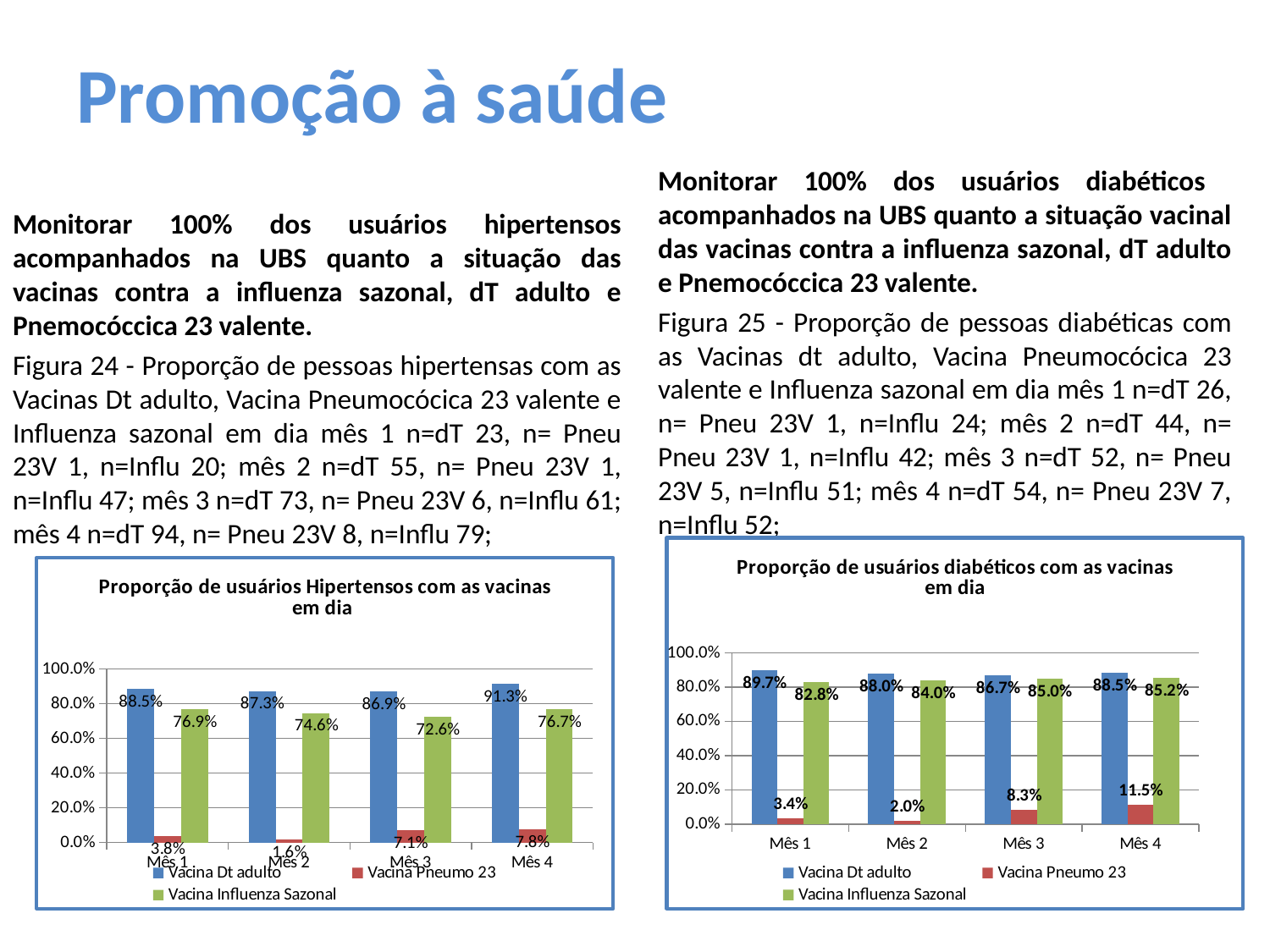
In the chart titled 'Proporção de usuários diabéticos com as vacinas em dia', what is the value for Vacina Influenza Sazonal in Mês 2? 84.0% In the chart titled 'Proporção de usuários diabéticos com as vacinas em dia', does Vacina Influenza Sazonal rise or fall from Mês 1 to Mês 4? rise In the chart titled 'Proporção de usuários diabéticos com as vacinas em dia', in which month is Vacina Dt adulto highest? Mês 1 In the chart titled 'Proporção de usuários Hipertensos com as vacinas em dia', what is the value for Vacina Influenza Sazonal in Mês 3? 72.6% In the chart titled 'Proporção de usuários Hipertensos com as vacinas em dia', what is the value for Vacina Dt adulto in Mês 4? 91.3% In the chart titled 'Proporção de usuários Hipertensos com as vacinas em dia', in which month is Vacina Pneumo 23 lowest? Mês 2 In the chart titled 'Proporção de usuários Hipertensos com as vacinas em dia', how many series does the legend list? 3 In the chart titled 'Proporção de usuários diabéticos com as vacinas em dia', how many months are shown on the x axis? 4 What kind of chart is the chart titled 'Proporção de usuários diabéticos com as vacinas em dia'? bar chart In the chart titled 'Proporção de usuários diabéticos com as vacinas em dia', which is larger in Mês 3: Vacina Dt adulto or Vacina Influenza Sazonal? Vacina Dt adulto In the chart titled 'Proporção de usuários diabéticos com as vacinas em dia', what is the value for Vacina Pneumo 23 in Mês 4? 11.5% In the chart titled 'Proporção de usuários Hipertensos com as vacinas em dia', what is the difference between Vacina Dt adulto and Vacina Influenza Sazonal in Mês 1? 11.6%